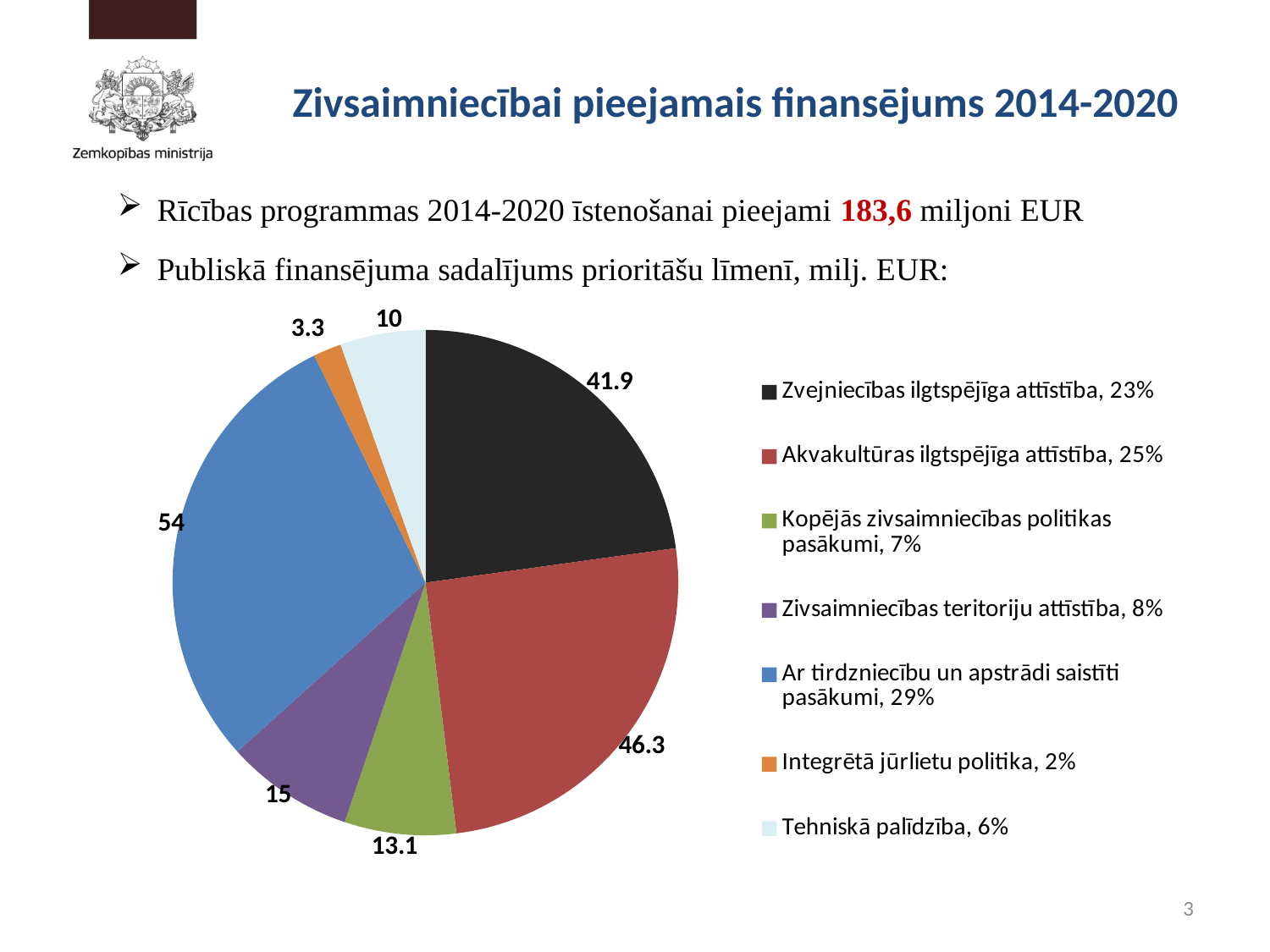
What is the value for Tehniskā palīdzība? 10 What colour is the slice for Kopējās zivsaimniecības politikas pasākumi? green Which is larger: the value for Zivsaimniecības teritoriju attīstība or the value for Kopējās zivsaimniecības politikas pasākumi? Zivsaimniecības teritoriju attīstība What is the value for Integrētā jūrlietu politika? 3.3 Which category has the smallest slice of the pie? Integrētā jūrlietu politika What is the value for Ar tirdzniecību un apstrādi saistīti pasākumi? 54 Which category has the largest slice of the pie? Ar tirdzniecību un apstrādi saistīti pasākumi What type of chart is shown on the slide? pie chart What is the value for Akvakultūras ilgtspējīga attīstība? 46.3 According to the legend, what share of the pie does Zvejniecības ilgtspējīga attīstība represent? 23% How many slices does the pie chart have? 7 What is the difference between the values for Akvakultūras ilgtspējīga attīstība and Zvejniecības ilgtspējīga attīstība? 4.4